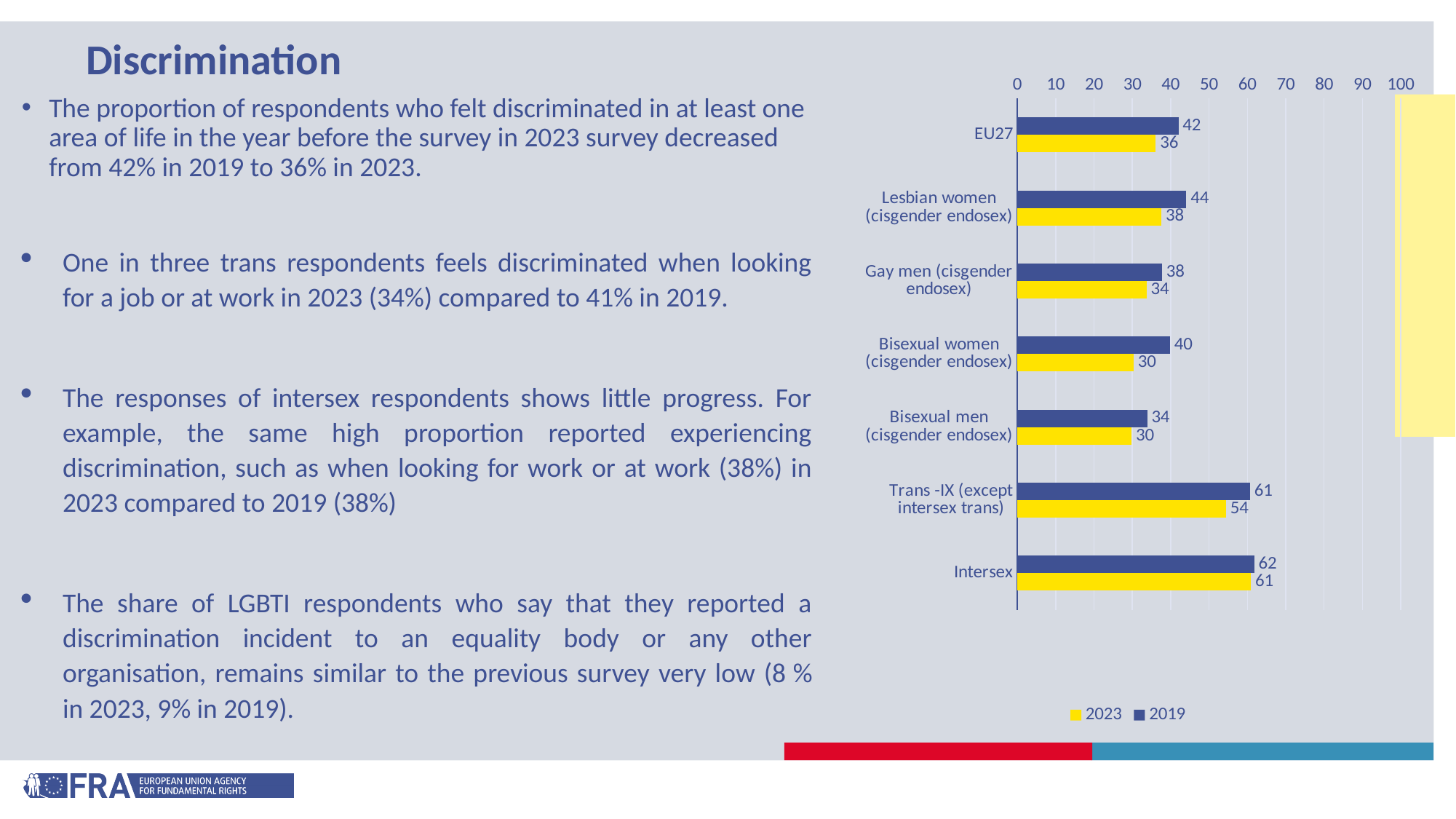
How many categories are shown on the chart? 7 Is the 2023 value for Intersex greater or less than 50? greater Which is larger for Gay men (cisgender endosex): the 2019 value or the 2023 value? 2019 How many series does the legend list? 2 What kind of chart is shown on the slide? Bar chart Which category has the lowest 2019 value? Bisexual men (cisgender endosex) Which colour represents the 2023 series in the chart? Yellow What is the difference between the 2019 and 2023 values for Bisexual women (cisgender endosex)? 10 What is the 2023 value for Trans -IX (except intersex trans)? 54 Which category has the highest 2019 value? Intersex What is the 2019 value for Lesbian women (cisgender endosex)? 44 What is the 2023 value for EU27? 36